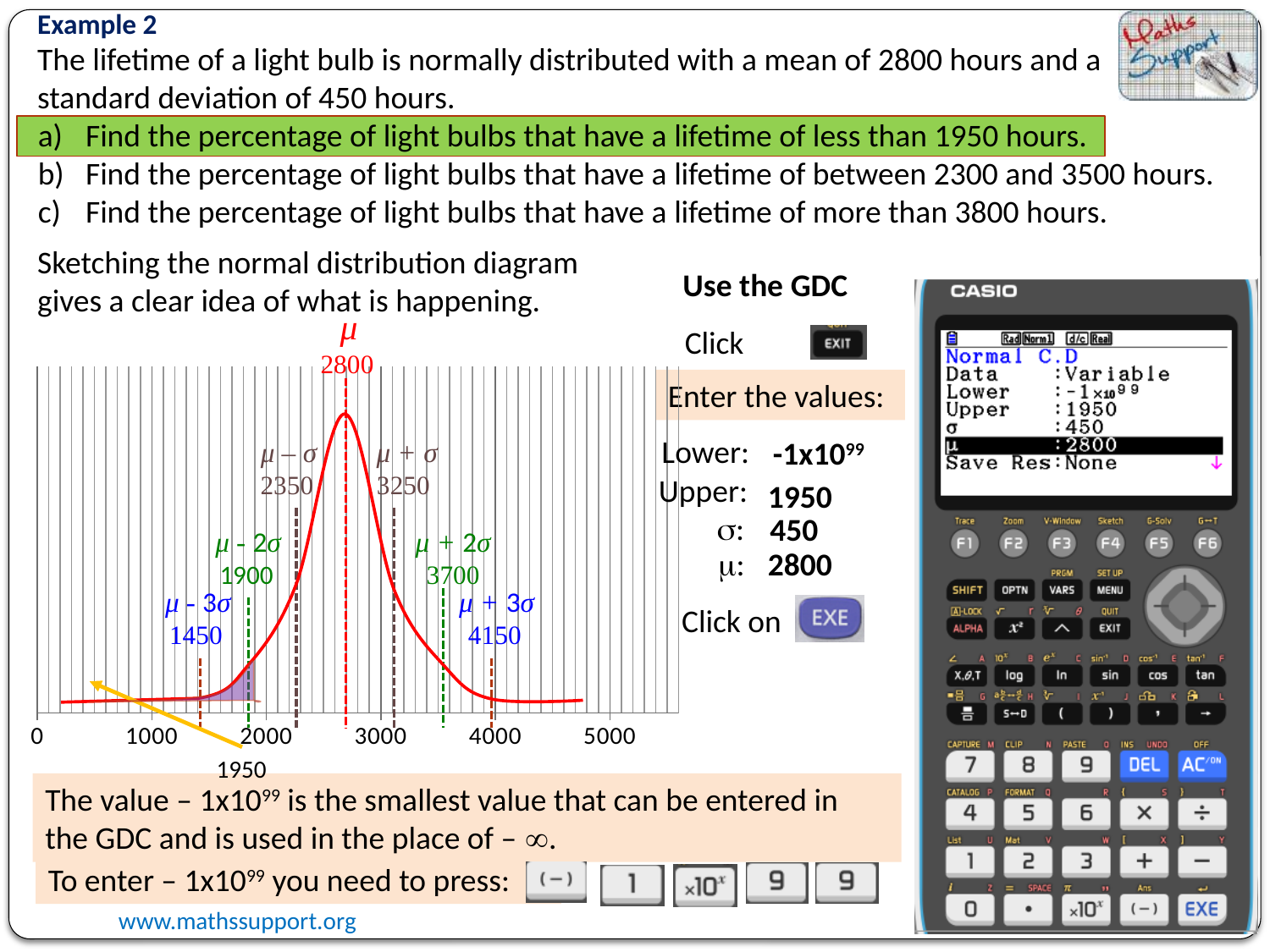
What kind of chart is the normal distribution diagram on the slide? line chart On the normal distribution chart, which labelled value is larger, μ + 2σ or μ + 3σ? μ + 3σ On the normal distribution chart, what value is labelled at μ − 3σ? 1450 On the normal distribution chart, what value is labelled at μ − σ? 2350 On the normal distribution chart, what is the difference between the values labelled at μ + σ and μ − σ? 900 On the normal distribution chart, what value is labelled at μ + 3σ? 4150 On the normal distribution chart, is the value labelled at μ greater or less than 3000? less On the normal distribution chart, what value marks the right edge of the shaded region under the curve? 1950 On the normal distribution chart, what value is labelled at μ + 2σ? 3700 How many tick labels are shown on the x axis of the normal distribution chart? 6 On the normal distribution chart, what is the difference between the values labelled at μ and μ − 2σ? 900 On the normal distribution chart, what value is labelled at the mean μ? 2800